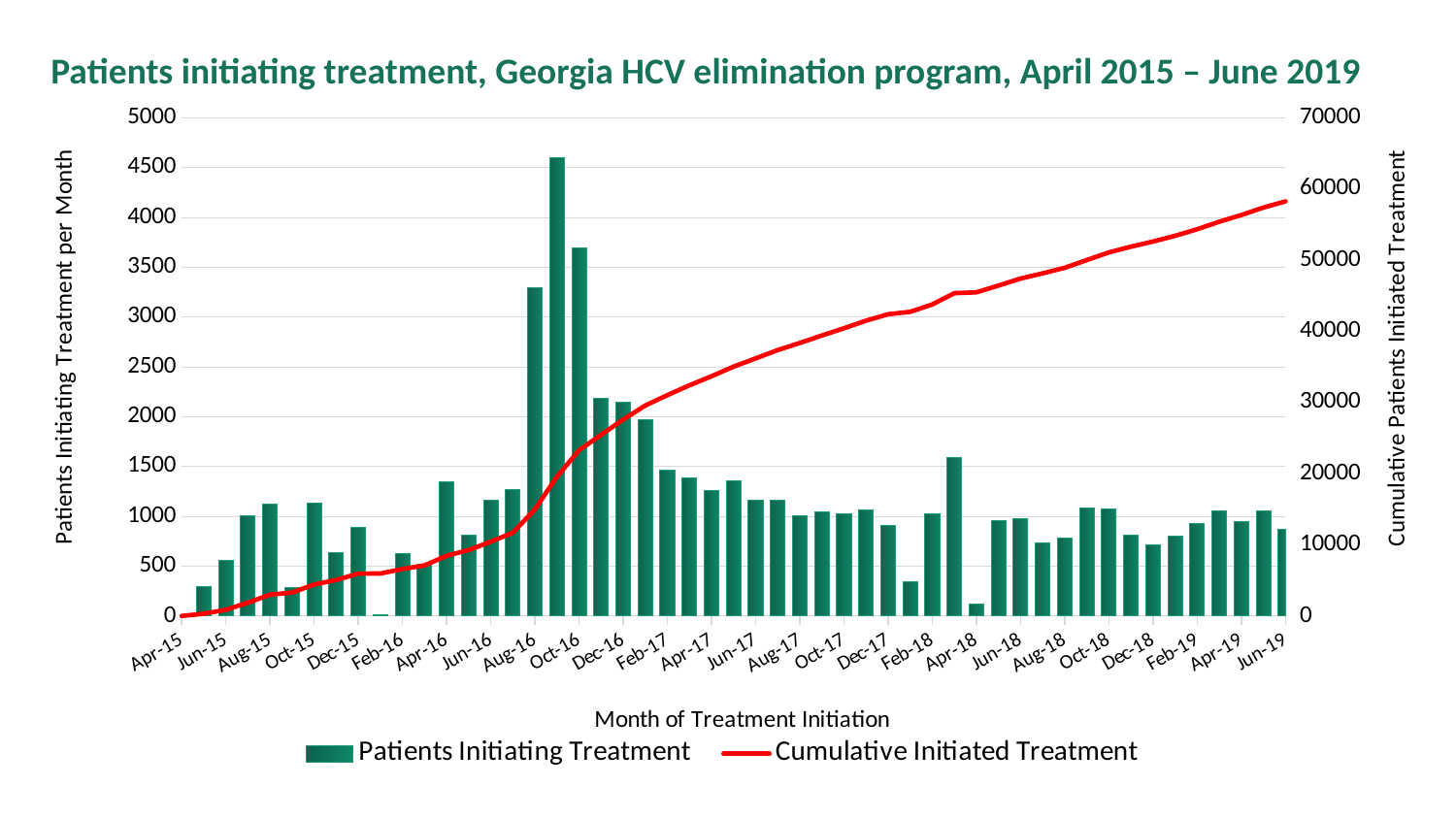
What is the label of the right-hand vertical axis? Cumulative Patients Initiated Treatment Is the Cumulative Initiated Treatment value in Apr-16 greater or less than 10000? less Is the value for Patients Initiating Treatment in Aug-16 greater or less than 3000? greater Is the value for Patients Initiating Treatment in Dec-16 greater or less than 1500? greater Does the Cumulative Initiated Treatment line rise or fall from Apr-15 to Jun-19? rise Which month has the larger number of Patients Initiating Treatment, Aug-16 or Apr-18? Aug-16 What type of chart is shown on the slide? Combined bar and line chart How many series does the legend list? 2